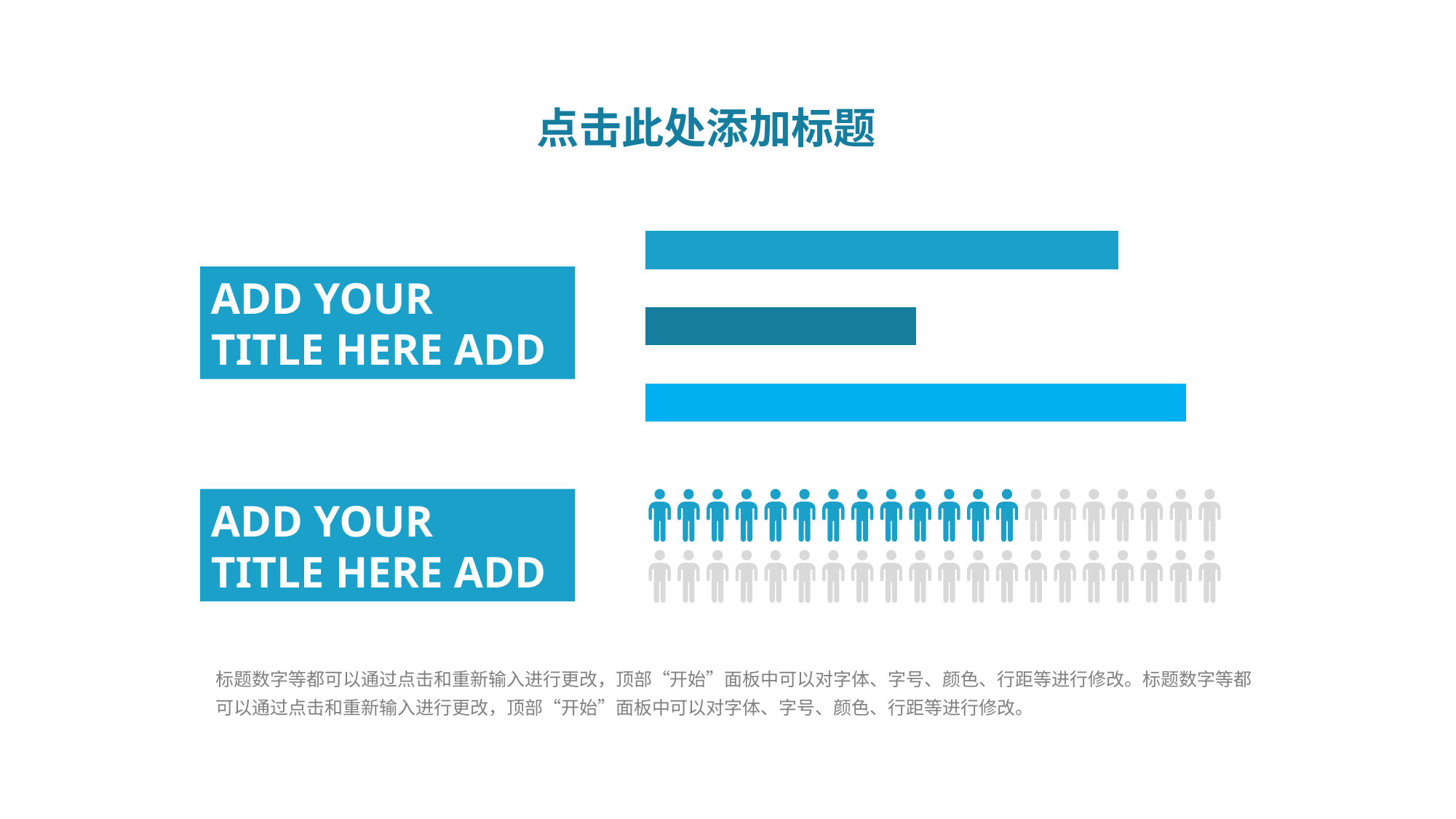
In the bar chart in the upper right, is the top bar or the middle bar longer? the top bar In the bar chart in the upper right, which bar is the shortest? the middle bar In the pictogram of people icons in the lower right, how many icons are there in total? 40 In the bar chart in the upper right, is the top bar or the bottom bar longer? the bottom bar What kind of chart is shown in the upper right of the slide? bar chart In the bar chart in the upper right, which bar is the longest? the bottom bar How many bars does the bar chart in the upper right contain? 3 In the pictogram of people icons in the lower right, how many rows of icons are there? 2 In the bar chart in the upper right, are the bars horizontal or vertical? horizontal In the bar chart in the upper right, what colour is the middle bar? dark blue